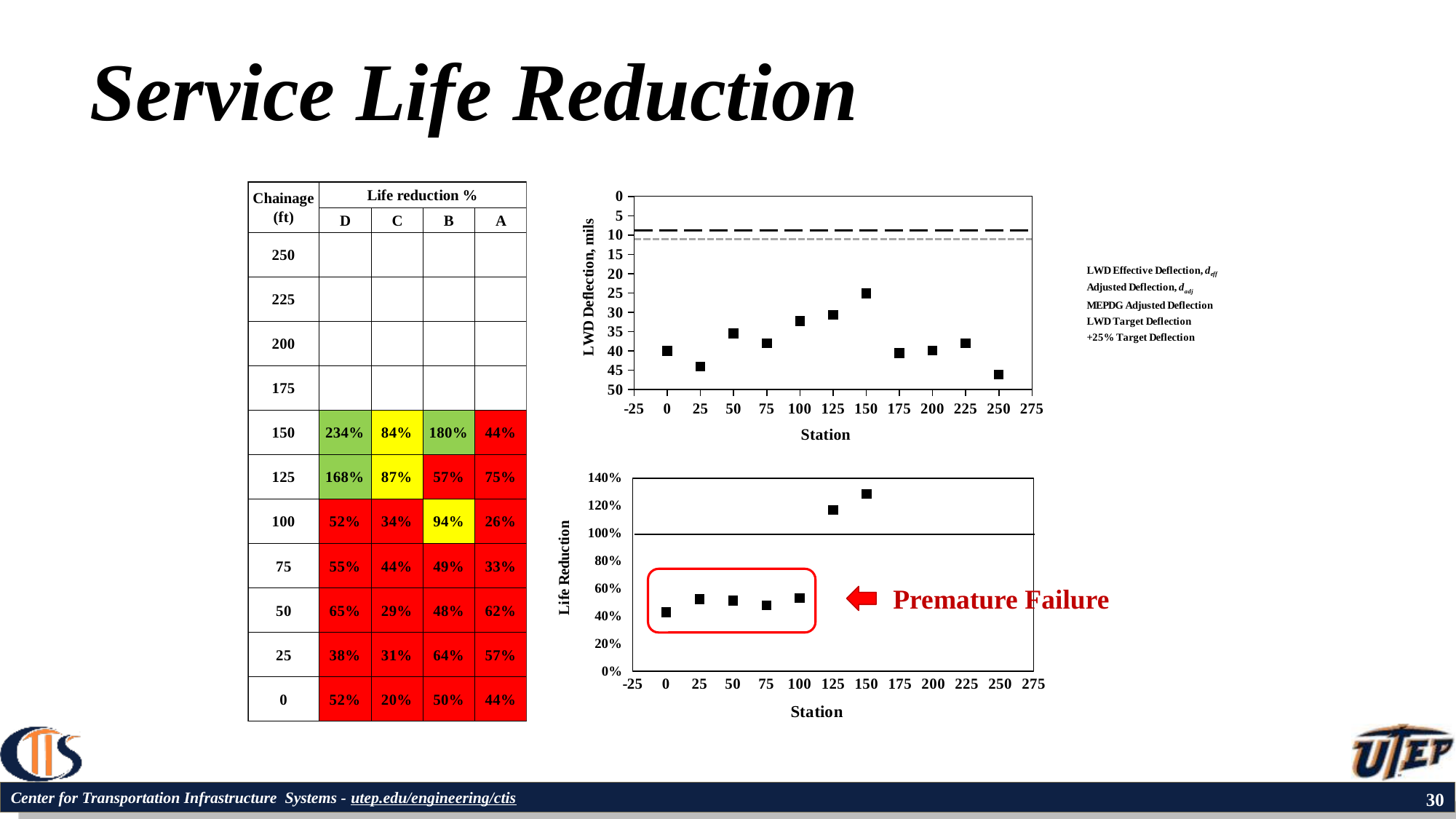
In the top chart (LWD Deflection vs Station), is the deflection at station 0 greater or less than 30 mils? greater How many data points are plotted in the top chart (LWD Deflection vs Station)? 11 In the top chart (LWD Deflection vs Station), at which station is the deflection lowest? 150 In the bottom chart (Life Reduction vs Station), at which station is the life reduction highest? 150 In the bottom chart (Life Reduction vs Station), is the value at station 150 greater or less than 120%? greater In the bottom chart (Life Reduction vs Station), at which station is the life reduction lowest? 0 What kind of chart is the bottom chart (Life Reduction vs Station)? scatter chart How many entries does the legend of the top chart (LWD Deflection vs Station) list? 5 In the bottom chart (Life Reduction vs Station), is the value at station 0 greater or less than 60%? less How many data points are plotted in the bottom chart (Life Reduction vs Station)? 7 In the bottom chart (Life Reduction vs Station), which has the larger life reduction, station 150 or station 50? station 150